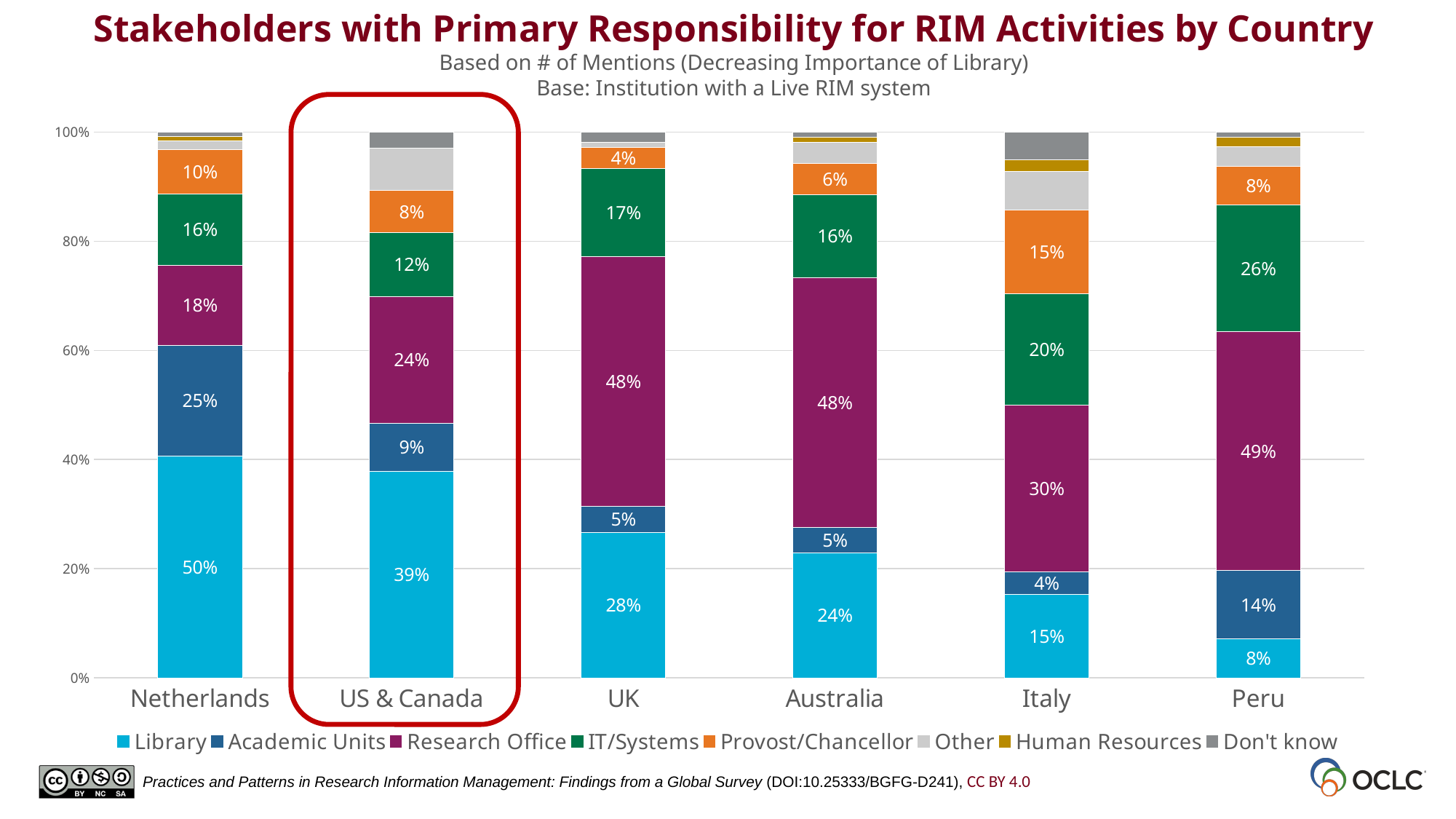
What is the Library share for the Netherlands? 50% What is the Provost/Chancellor share for the UK? 4% Does the Library share rise or fall moving from Netherlands to Peru along the x axis? Fall How many series does the legend list? 8 How many countries are shown on the x axis? 6 What is the IT/Systems share for Italy? 20% What is the difference between the Library share for the Netherlands and for US & Canada? 11% What kind of chart is shown on the slide? Stacked bar chart Which country has the highest Library share? Netherlands Which is larger, the Academic Units share for the Netherlands or for Peru? Netherlands Which country has the lowest Library share? Peru What is the Research Office share for Peru? 49%